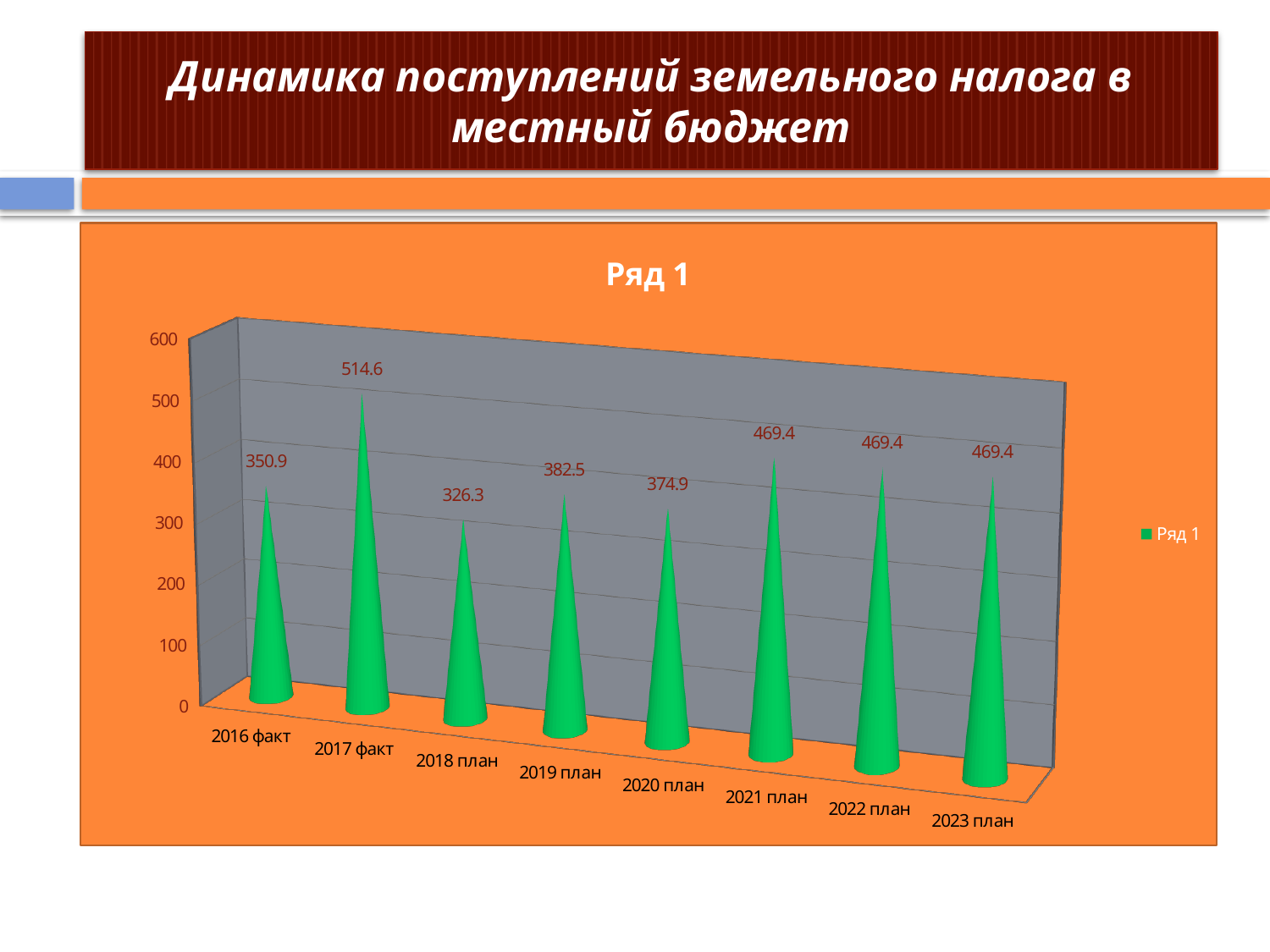
Which category has the lowest value? 2018 план What is the value for 2020 план? 374.9 What is the value for 2018 план? 326.3 What kind of chart is shown on the slide? bar chart Which is larger, the value for 2019 план or the value for 2020 план? 2019 план How many categories are shown on the x axis? 8 How many series does the legend list? 1 What is the title of the chart? Ряд 1 Which category has the highest value? 2017 факт What is the difference between the values for 2017 факт and 2016 факт? 163.7 What is the value for 2017 факт? 514.6 Is the value for 2021 план greater or less than 400? greater